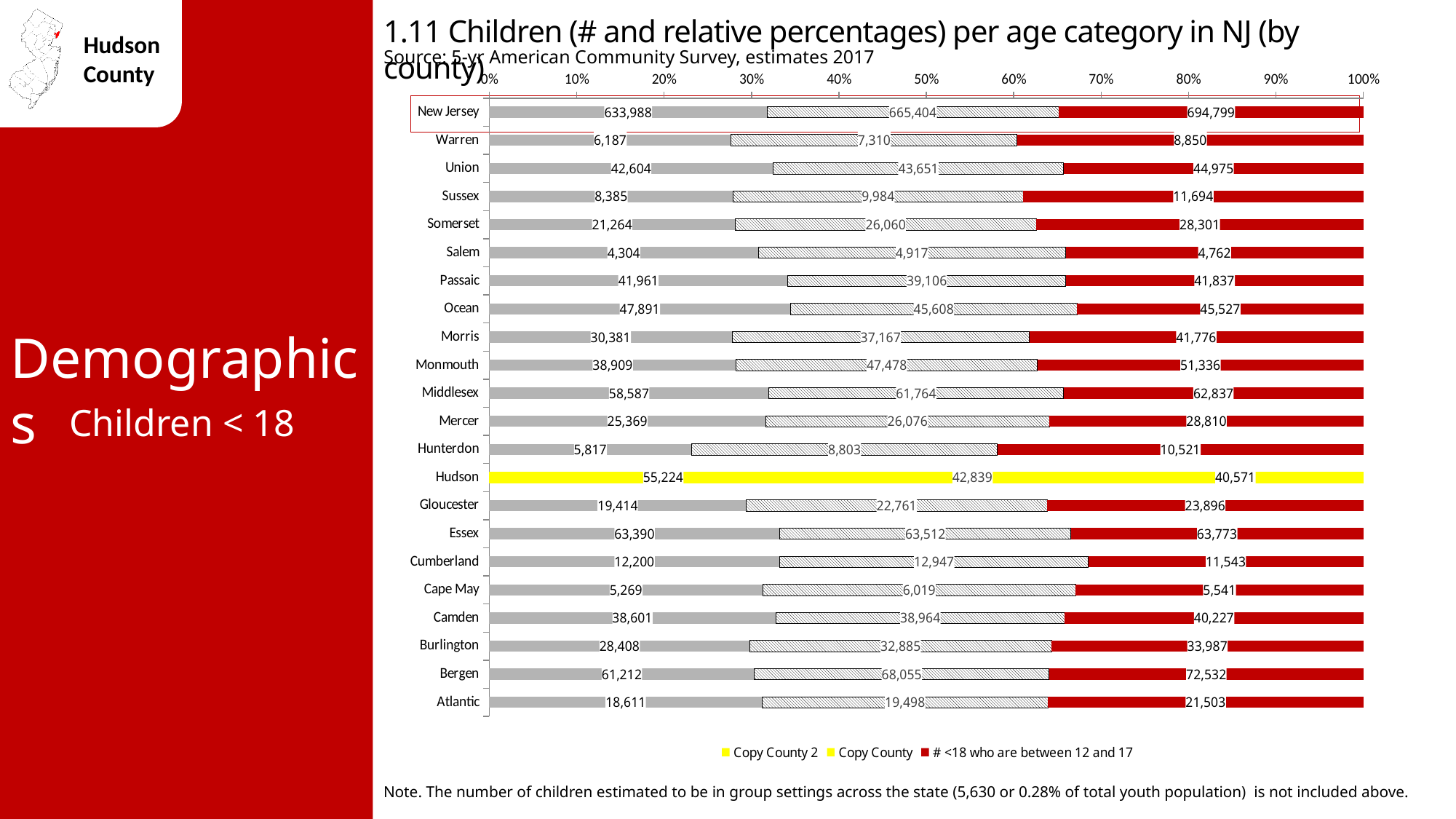
What is the value of the '# <18 who are between 12 and 17' segment for Hudson? 40,571 Which county's bar is highlighted in yellow on the chart? Hudson Which is larger, Essex's or Camden's '# <18 who are between 12 and 17' value? Essex What is the total of the three segments in the Hudson bar? 138,634 Among the counties (excluding New Jersey), which has the lowest value for '# <18 who are between 12 and 17'? Salem What kind of chart is shown on the slide? Stacked bar chart What is the value of the leftmost (first) segment for New Jersey? 633,988 Among the counties (excluding New Jersey), which has the highest value for '# <18 who are between 12 and 17'? Bergen How many series does the chart legend list? 3 How many counties/regions are listed on the vertical axis of the chart? 22 What is the difference between Bergen's and Atlantic's '# <18 who are between 12 and 17' values? 51,029 What is the value of the '# <18 who are between 12 and 17' segment for Bergen? 72,532